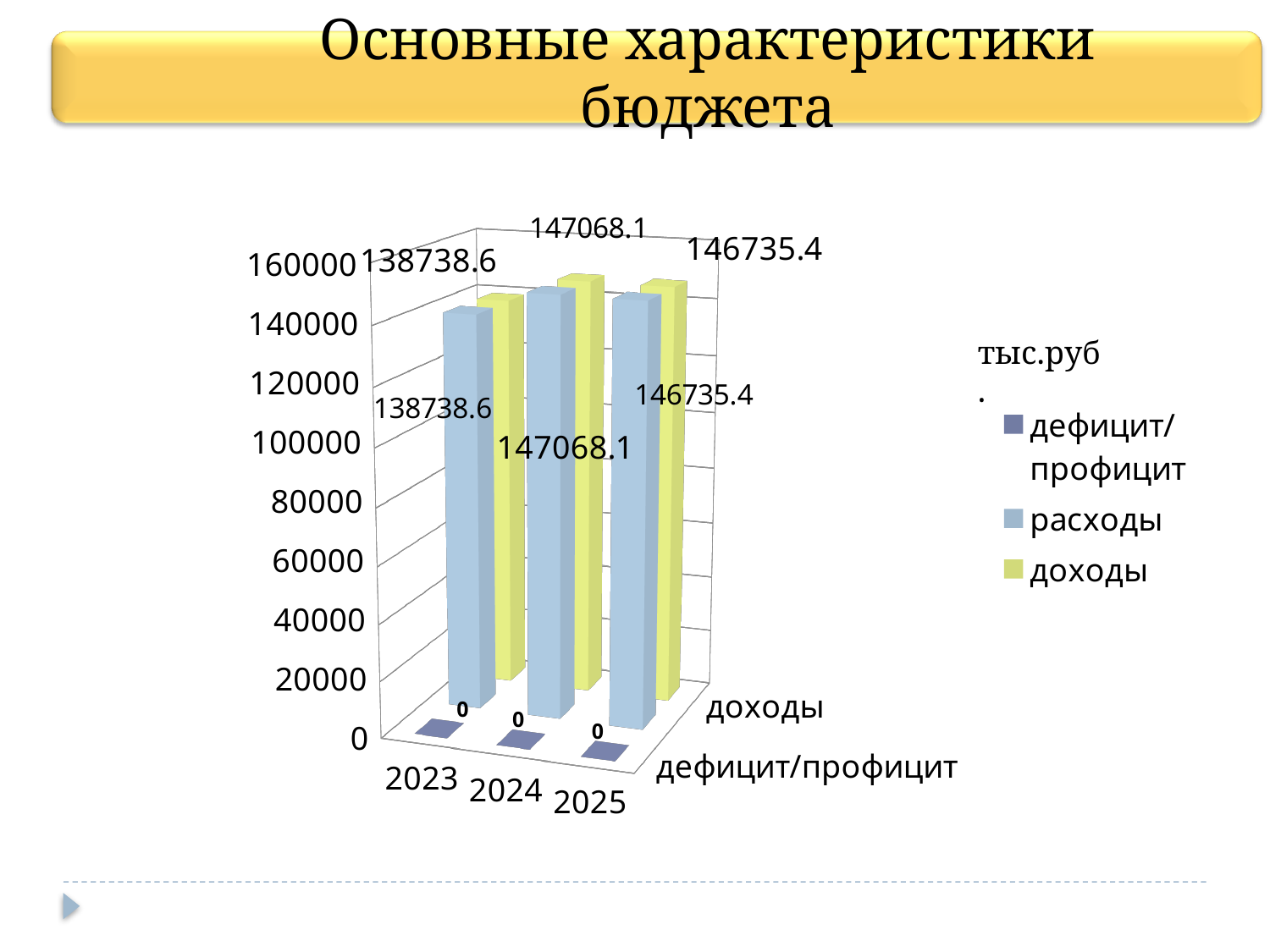
Which year has the highest value of доходы? 2024 Is the value of расходы for 2023 greater or less than 120000? greater What unit is indicated next to the legend of the chart? тыс.руб. What is the value of доходы for 2024? 147068.1 How many years are shown on the x axis of the chart? 3 What is the value of дефицит/профицит for 2024? 0 What is the value of расходы for 2025? 146735.4 What is the difference between доходы in 2024 and доходы in 2023? 8329.5 What type of chart is shown on the slide? bar chart Which year has the lowest value of расходы? 2023 How many series does the legend list? 3 What is the value of доходы for 2023? 138738.6